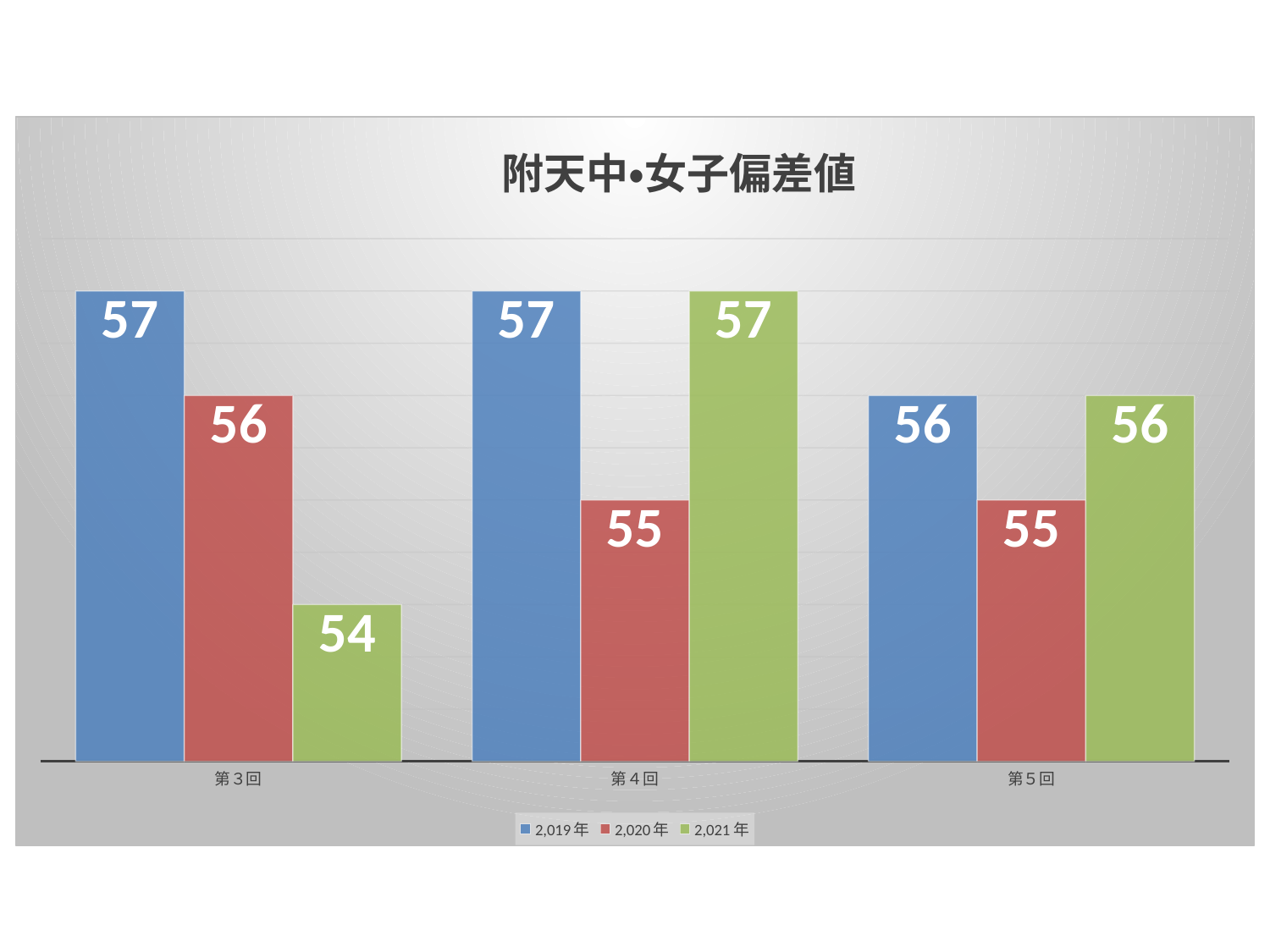
Which year has the lowest value in 第3回? 2,021年 What is the value for 2,020年 in 第4回? 55 What is the value for 2,021年 in 第3回? 54 How many series does the legend list? 3 What is the difference between the 2,019年 and 2,021年 values in 第3回? 3 Which year has the lowest value in 第4回? 2,020年 What is the value for 2,021年 in 第5回? 56 What kind of chart is shown on the slide? bar chart How many categories are shown on the x axis? 3 What is the value for 2,019年 in 第3回? 57 What is the title of the chart? 附天中•女子偏差値 Which is larger in 第5回: the value for 2,019年 or the value for 2,020年? 2,019年